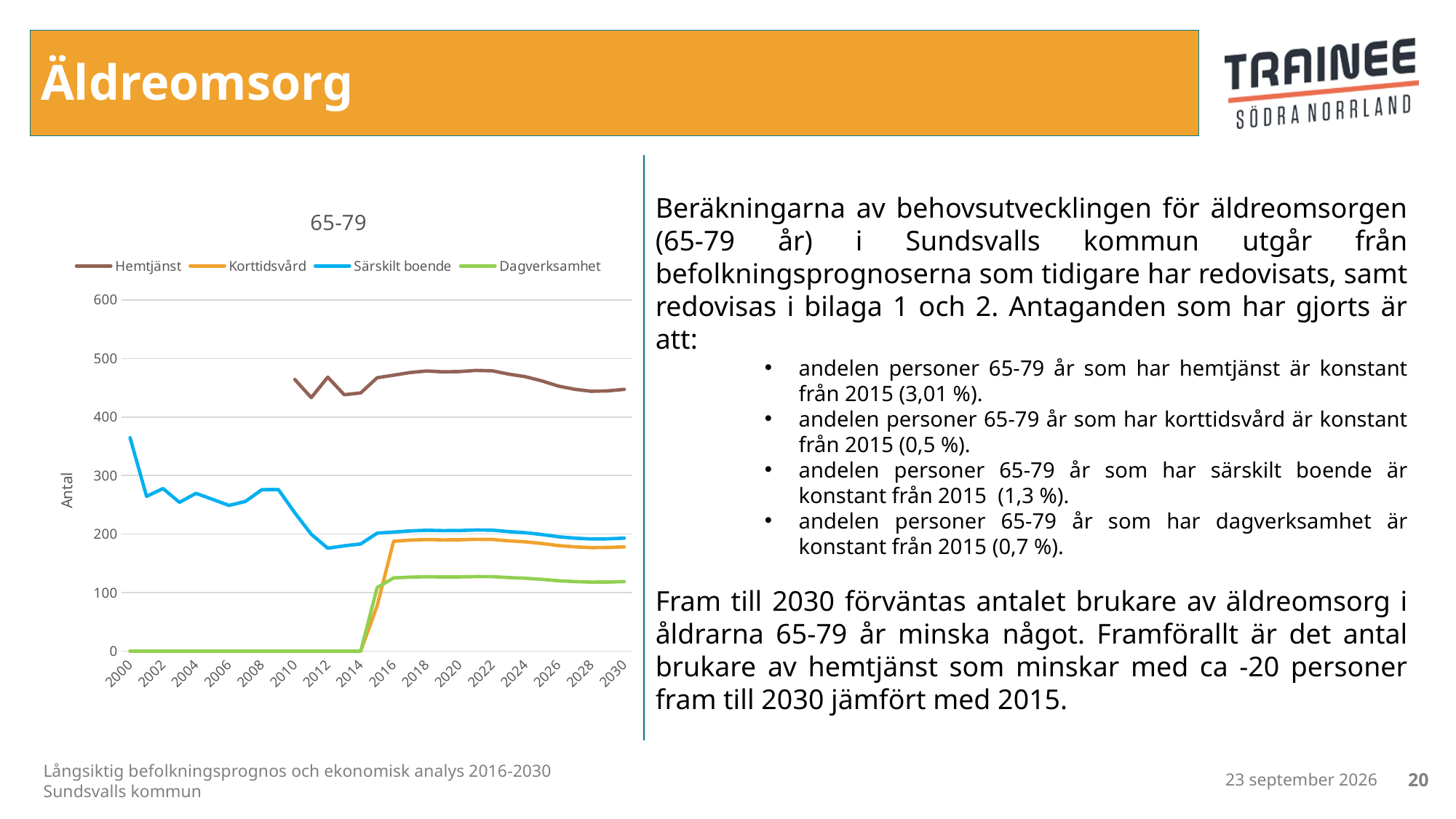
Does the Särskilt boende line rise or fall between 2000 and 2012? fall Is the value for Dagverksamhet in 2010 greater or less than 100? less Is the value for Hemtjänst in 2020 greater or less than 400? greater How many series does the chart legend list? 4 Which is larger in 2030, Särskilt boende or Dagverksamhet? Särskilt boende Which series has the lowest value in 2020? Dagverksamhet Which series has the highest value in 2020? Hemtjänst What is the label on the vertical axis of the chart? Antal What is the title of the chart? 65-79 Is the value for Korttidsvård in 2030 greater or less than 200? less What kind of chart is shown on the slide? line chart